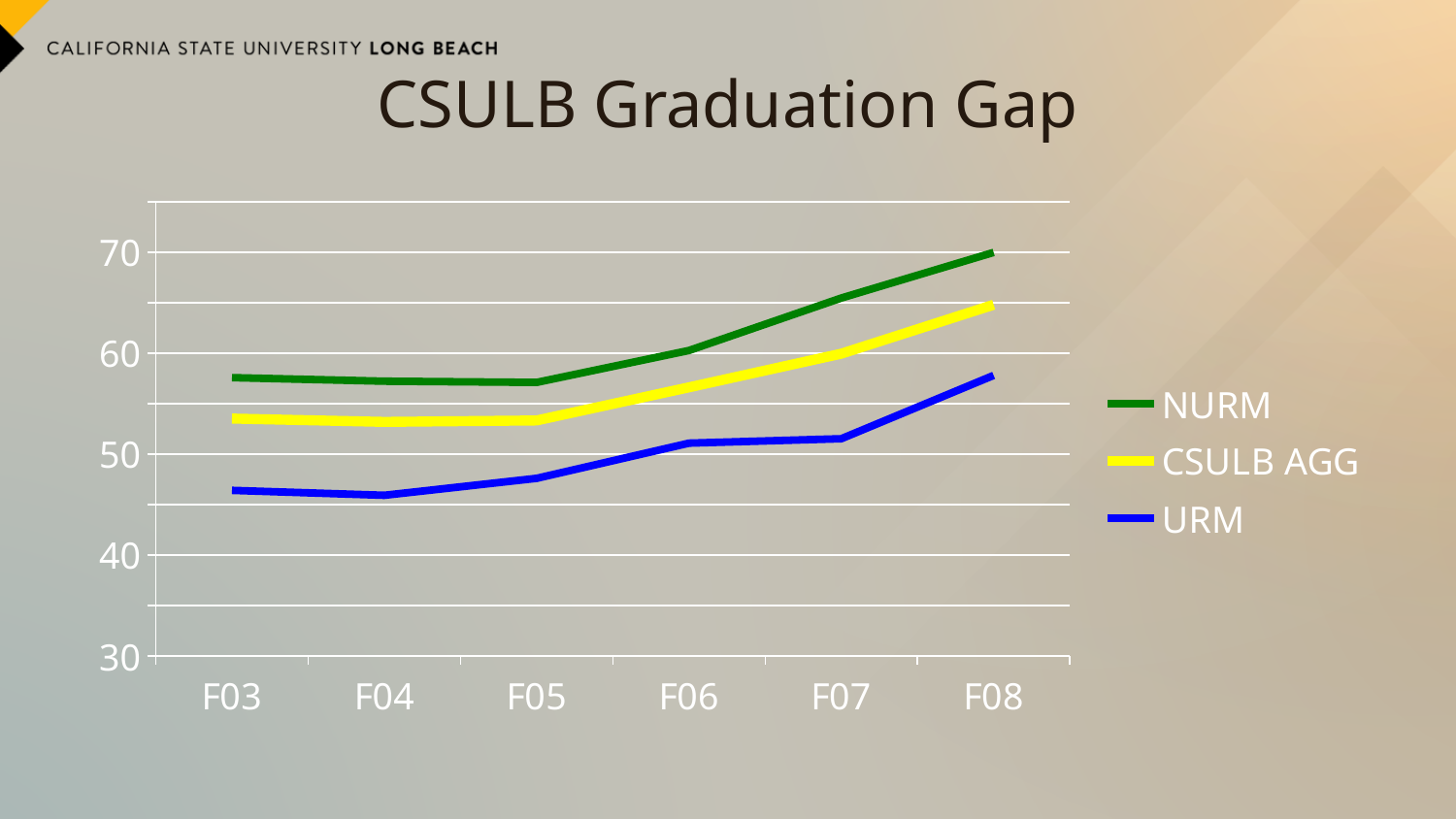
Which is larger at F06, the NURM value or the URM value? NURM Which series has the lowest value at F03? URM How many points are plotted along the x axis for each series? 6 Is the value for URM at F03 greater or less than 50? less At which x-axis category does the URM series reach its highest value? F08 Which series has the highest value at F08? NURM Is the value for NURM at F08 greater or less than 60? greater What kind of chart is shown on the slide? line chart What is the title of the chart? CSULB Graduation Gap How many series does the legend list? 3 Which series is drawn in blue? URM Does the CSULB AGG series rise or fall from F05 to F08? rise